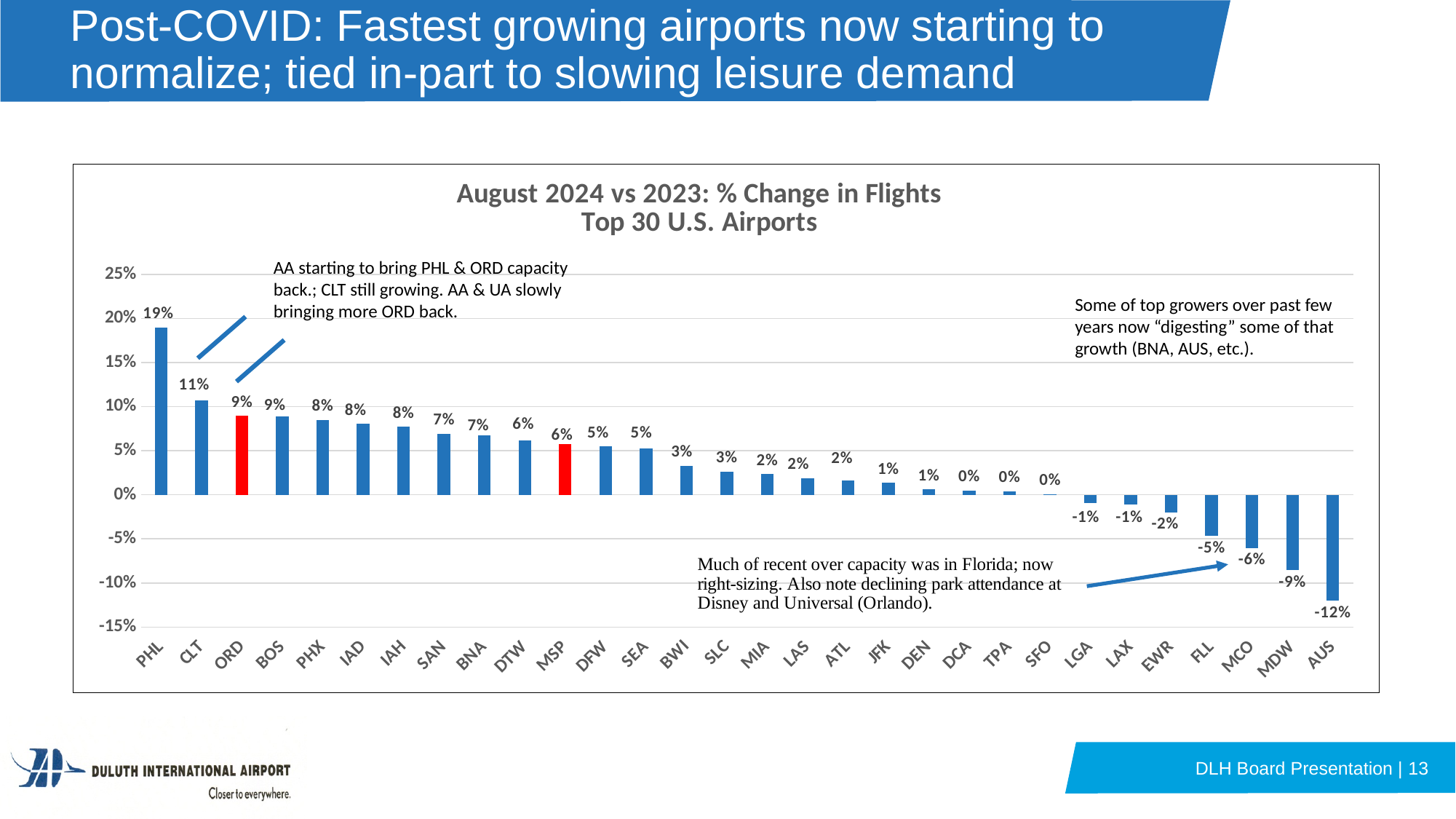
What is the % change in flights for MCO? -6% Do the values rise or fall moving from left to right along the x axis? Fall How many airports are shown on the chart? 30 Which has a larger % change in flights, CLT or ORD? CLT What is the difference in percentage points between PHL and CLT? 8 percentage points What is the % change in flights for AUS? -12% Which two airports' bars are highlighted in red? ORD and MSP What type of chart is shown on the slide? Bar chart Which airport has the lowest % change in flights? AUS What is the % change in flights for PHL? 19% What is the % change in flights for MSP? 6% Which airport has the highest % change in flights? PHL